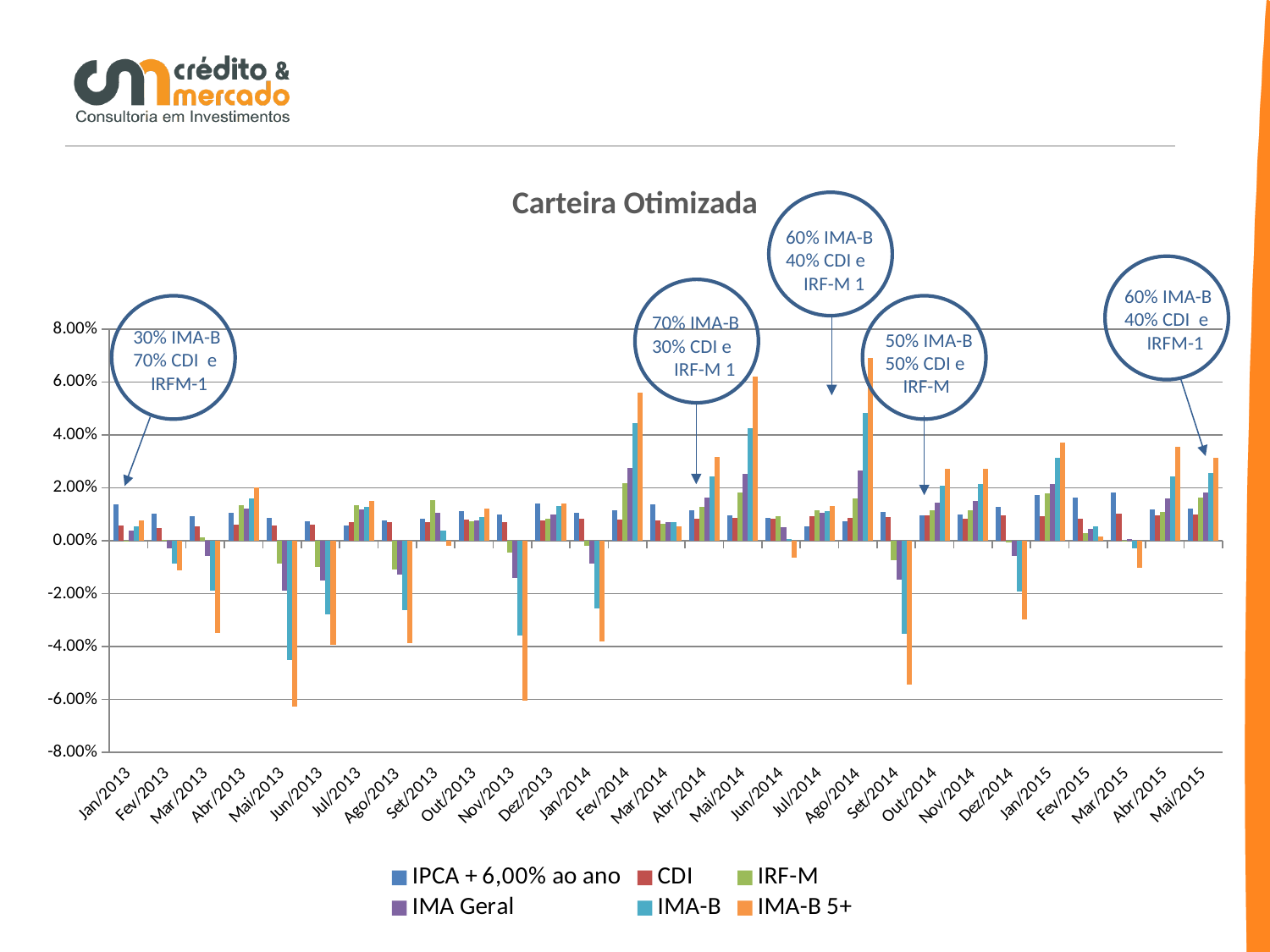
Is the value for IMA-B 5+ in Ago/2014 greater or less than 6.00%? greater Which series is listed first in the legend? IPCA + 6,00% ao ano How many months are shown along the x axis of the chart? 29 Is the value for IMA-B 5+ in Mai/2013 greater or less than -4.00%? less In Fev/2014, which is larger: the value for IMA-B 5+ or the value for IPCA + 6,00% ao ano? IMA-B 5+ Is the value for IMA-B in Nov/2013 greater or less than -2.00%? less How many series does the legend list? 6 What is the title of the chart? Carteira Otimizada In which month does the IMA-B series reach its lowest value? Mai/2013 In which month does the IMA-B 5+ series reach its highest value? Ago/2014 What type of chart is shown on the slide? bar chart